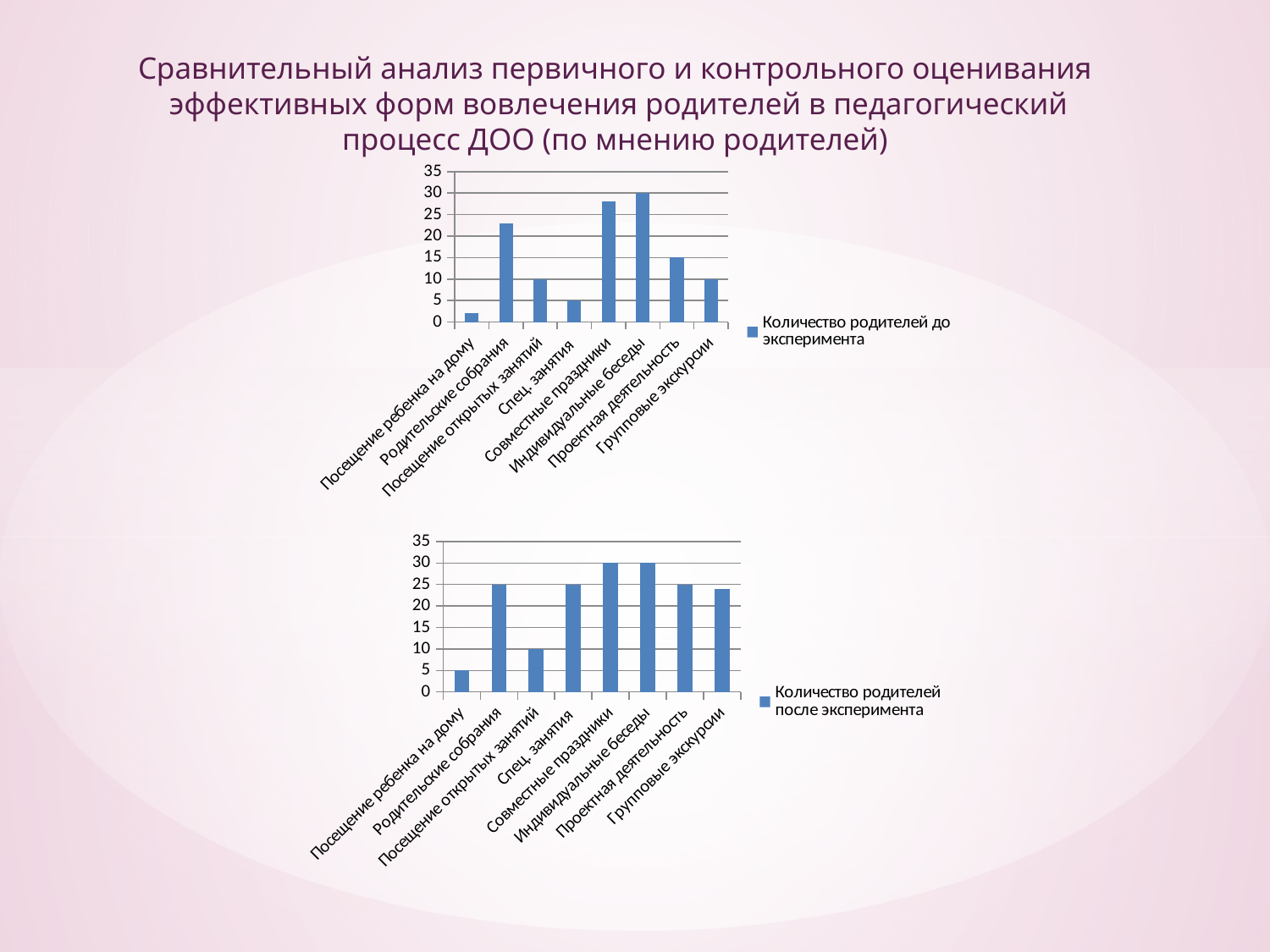
In the top chart, what is the value for Проектная деятельность? 15 What is the legend entry of the top chart? Количество родителей до эксперимента How many categories are shown in the top chart? 8 In the bottom chart, which is larger: Спец. занятия or Посещение открытых занятий? Спец. занятия In the bottom chart, which category has the lowest value? Посещение ребенка на дому In the bottom chart, is the value for Групповые экскурсии greater or less than 20? greater In the top chart, what is the value for Спец. занятия? 5 In the bottom chart, what is the value for Посещение открытых занятий? 10 In the bottom chart, what is the value for Родительские собрания? 25 In the top chart, is the value for Родительские собрания greater or less than 20? greater In the top chart, which category has the lowest value? Посещение ребенка на дому What kind of chart is the bottom chart? bar chart